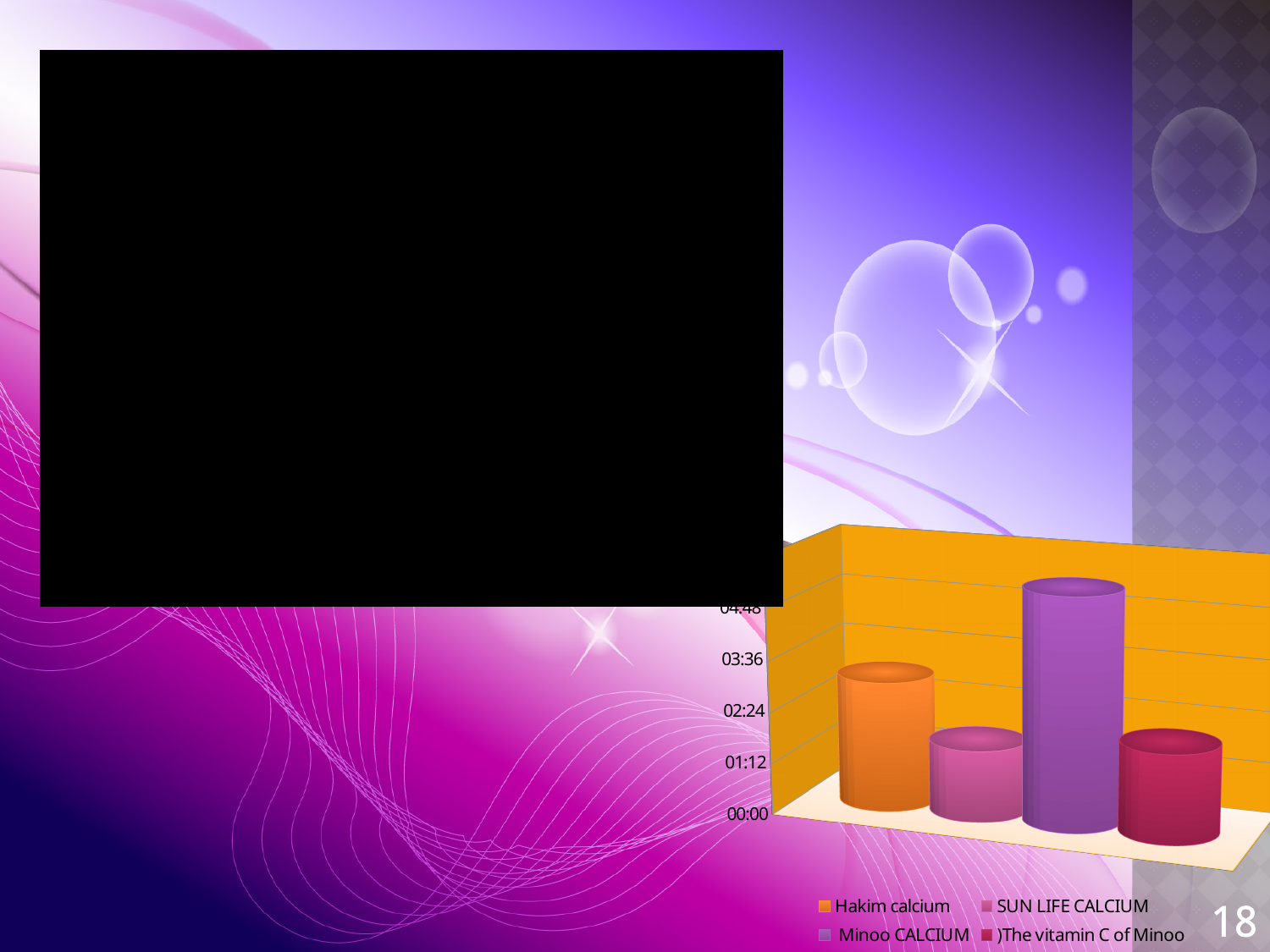
How many bars are plotted in the chart? 4 Which series has the tallest bar in the chart? Minoo CALCIUM What colour is the bar for Hakim calcium in the chart? orange How many series does the chart legend list? 4 Which is larger, the bar for Hakim calcium or the bar for SUN LIFE CALCIUM? Hakim calcium Is the value for The vitamin C of Minoo greater or less than 03:36? less Which series is shown in purple in the chart legend? Minoo CALCIUM Is the value for SUN LIFE CALCIUM greater or less than 03:36? less Which is larger, the bar for Minoo CALCIUM or the bar for Hakim calcium? Minoo CALCIUM Is the value for Minoo CALCIUM greater or less than 03:36? greater What kind of chart is shown on the slide? bar chart